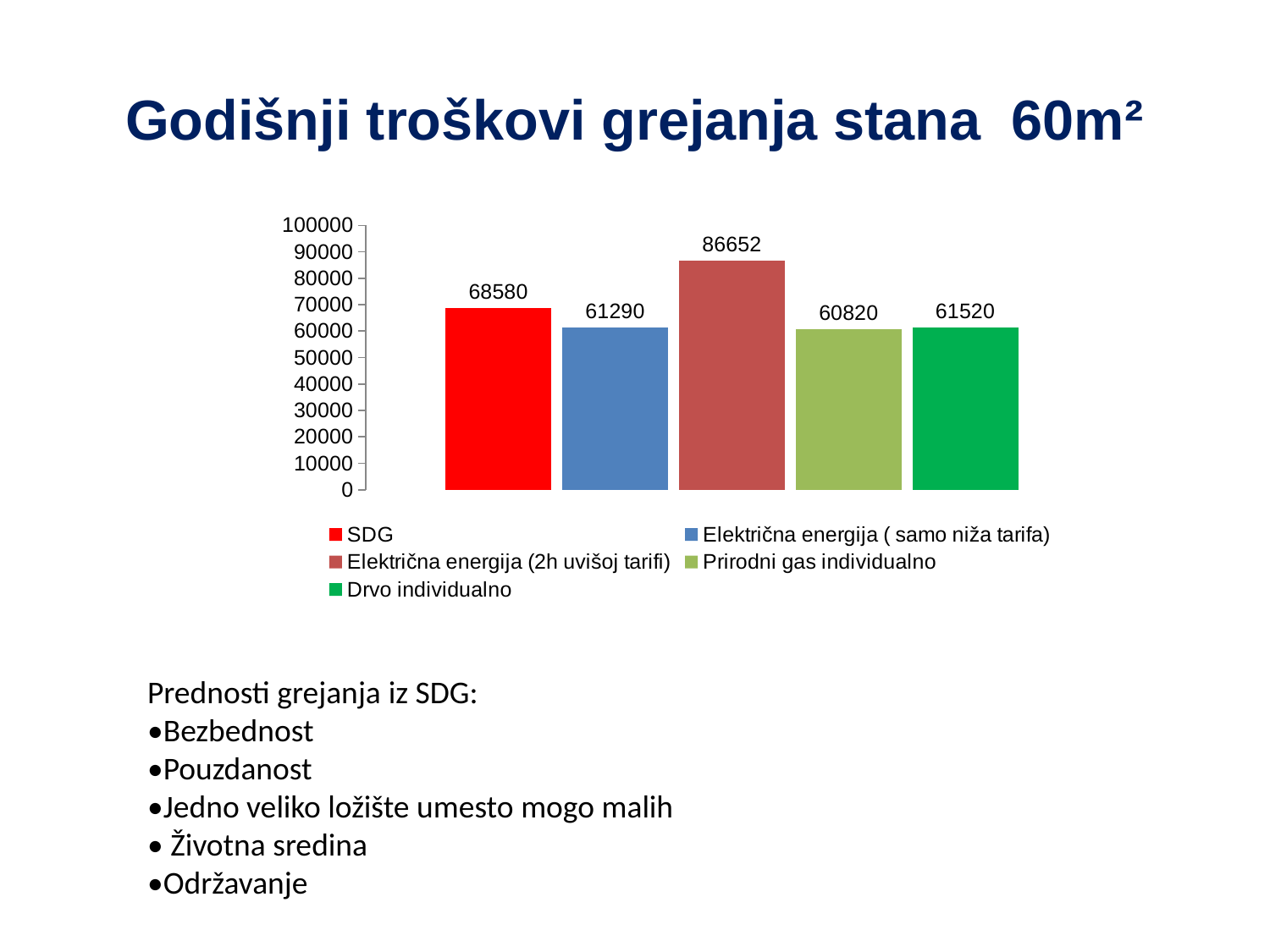
Which is larger, the cost for SDG or for Drvo individualno? SDG Which heating option has the highest annual cost? Električna energija (2h u višoj tarifi) What is the difference between the cost of Električna energija (2h u višoj tarifi) and SDG? 18072 What is the difference between the cost of SDG and Električna energija (samo niža tarifa)? 7290 Is the value for SDG greater or less than 60000? greater What is the value shown for Prirodni gas individualno? 60820 What kind of chart is shown on the slide? bar chart What is the value shown for Električna energija (2h u višoj tarifi)? 86652 How many bars are plotted in the chart? 5 What is the value shown for Drvo individualno? 61520 What is the annual heating cost for SDG? 68580 Which heating option has the lowest annual cost? Prirodni gas individualno